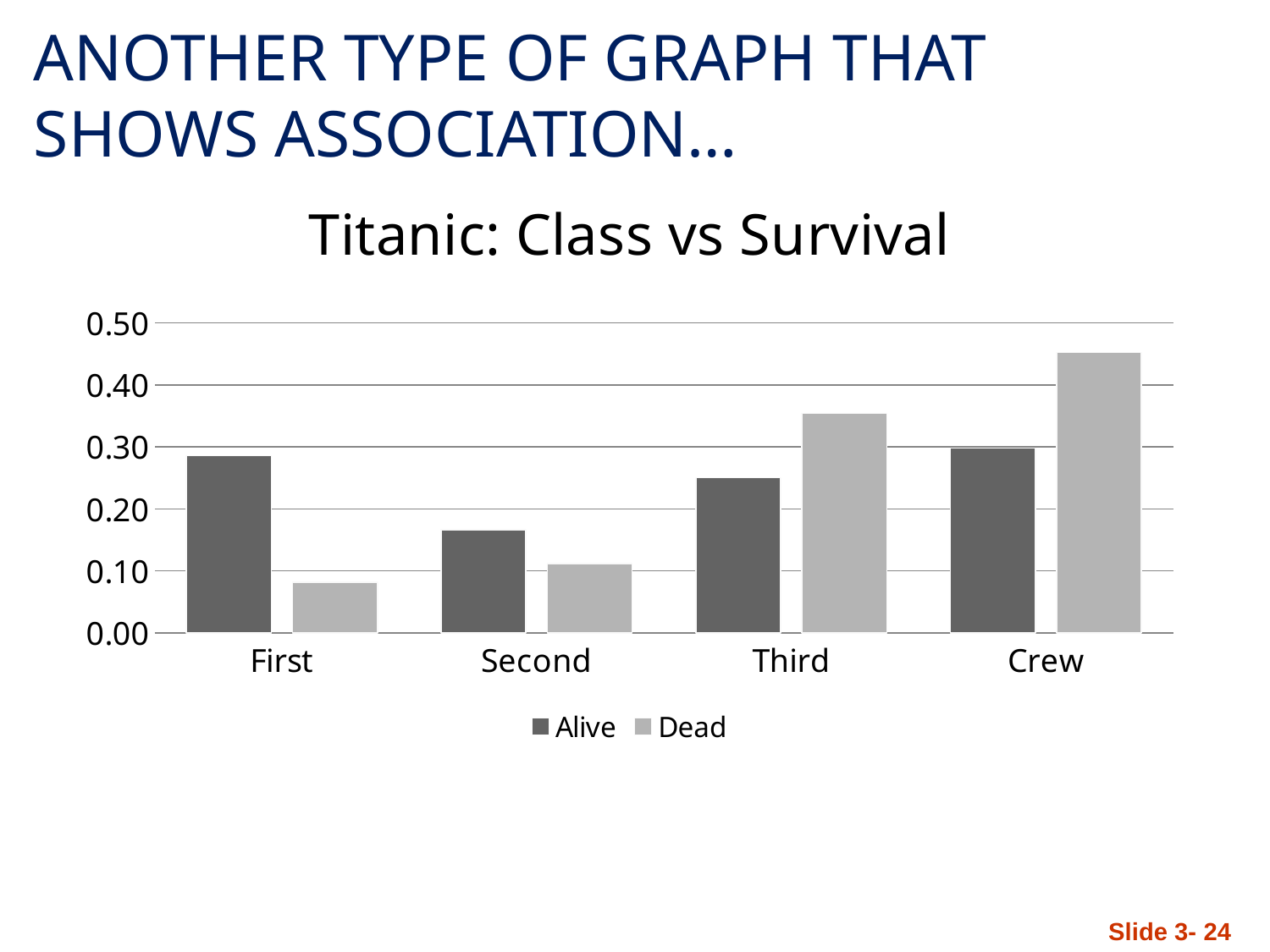
Which category has the lowest Alive value? Second Which category has the highest Dead value? Crew What is the title of the chart? Titanic: Class vs Survival How many series does the legend list? 2 Do the Dead values rise or fall moving from First to Crew along the x axis? rise Which category has the lowest Dead value? First How many categories are shown on the x axis? 4 Is the Dead value for Crew greater or less than 0.40? greater What type of chart is shown on the slide? Bar chart For the Third class, which is larger, the Alive value or the Dead value? Dead Is the Alive value for First greater or less than 0.20? greater Is the Dead value for First greater or less than 0.10? less